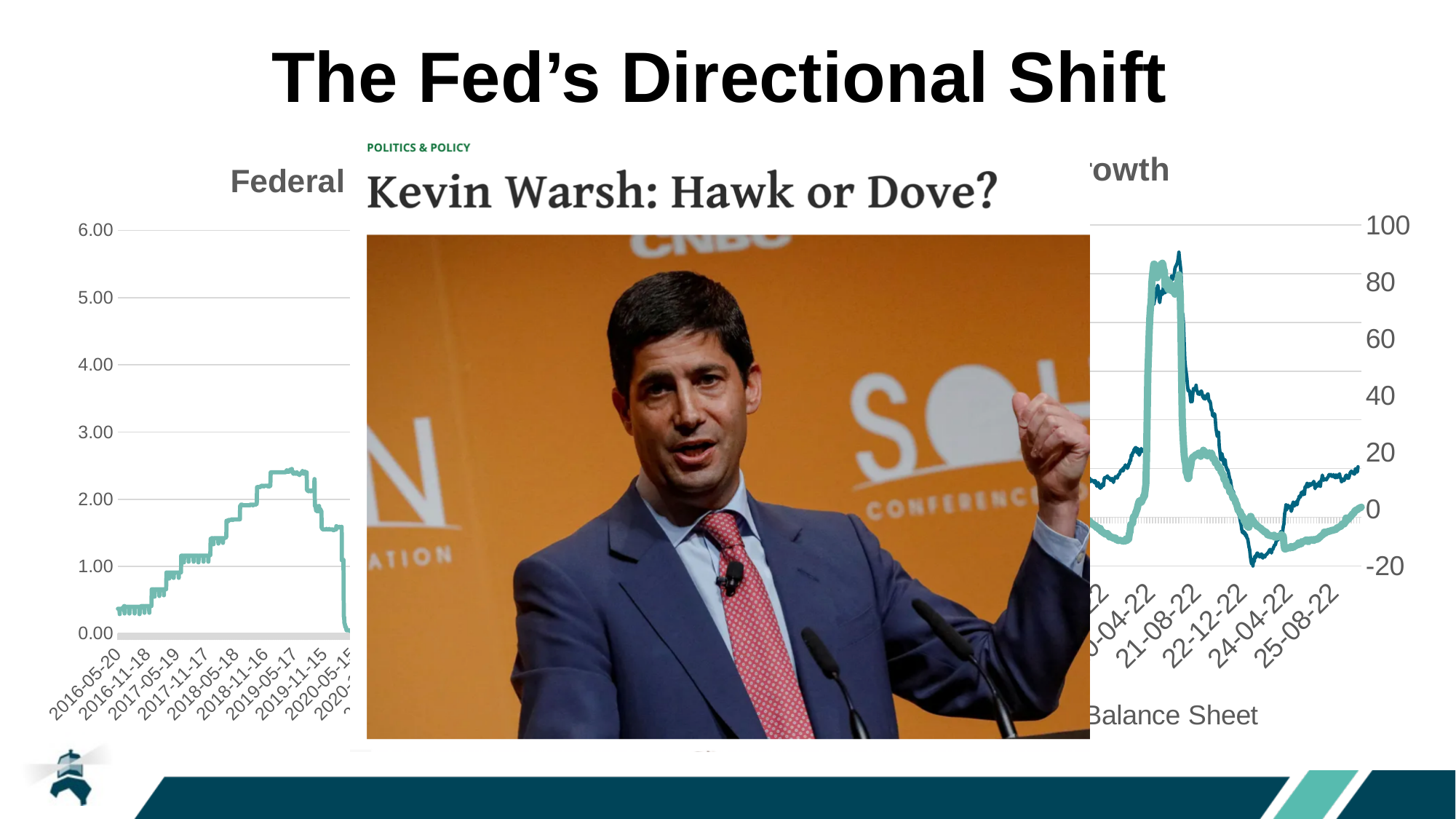
On the left chart, is the value around 2019-05-17 greater or less than 3.00? less On the left chart, is the value around 2019-05-17 greater or less than 2.00? greater What is the lowest tick shown on the y axis of the right chart? -20 On the left chart, do the values rise or fall from 2016-05-20 to 2019-05-17? rise On the left chart, is the value at 2016-05-20 greater or less than 1.00? less What is the highest tick shown on the y axis of the left chart? 6.00 On the right chart, do the values rise or fall from 21-08-22 to 22-12-22? fall What kind of chart is the chart on the left of the slide? line chart What kind of chart is the chart on the right of the slide? line chart